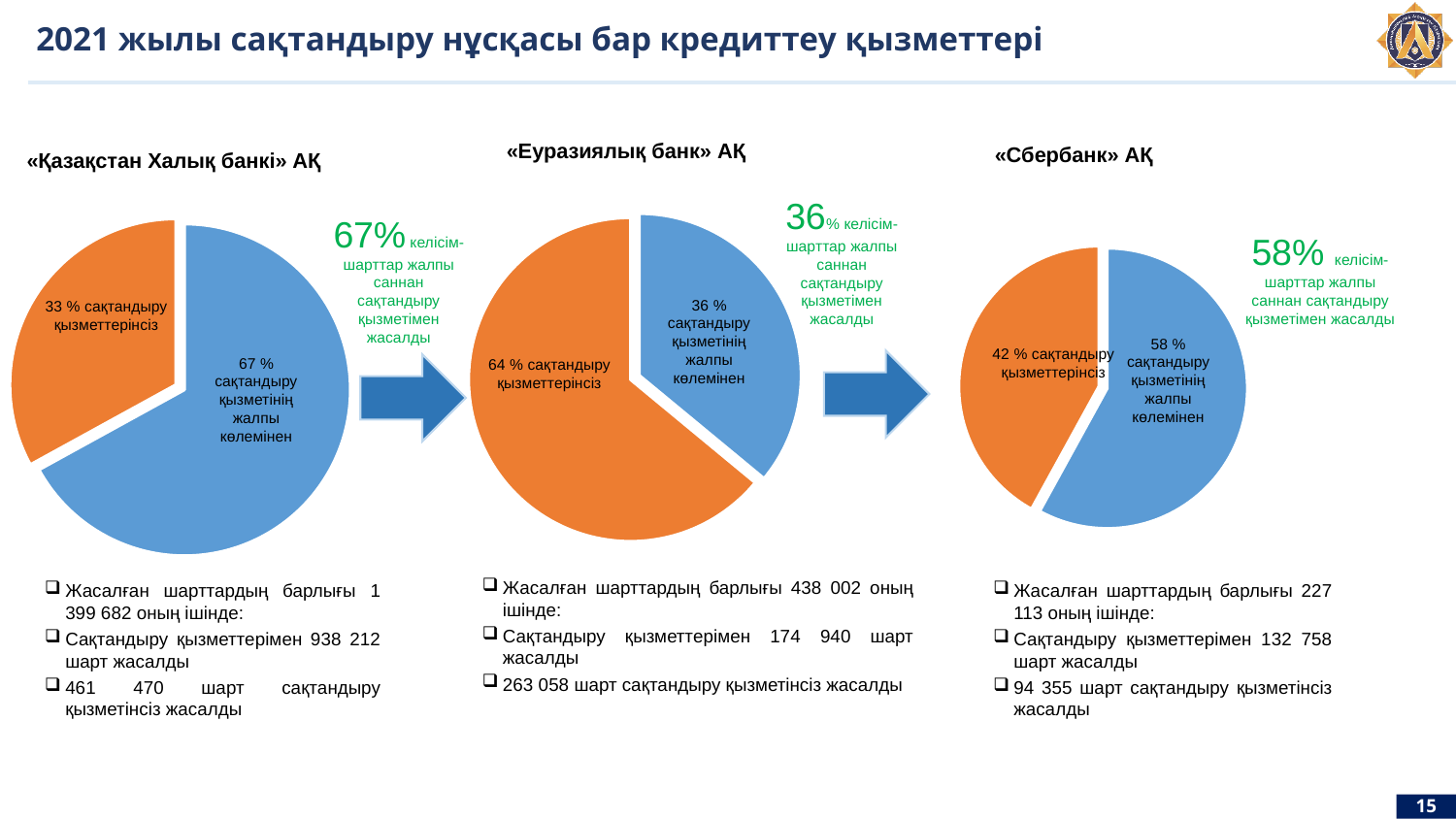
In the «Қазақстан Халық банкі» АҚ pie chart, what is the difference in percentage points between the slice with insurance services and the slice without? 34 In the «Сбербанк» АҚ pie chart, what share of contracts was made with insurance services? 58 % How many pie charts are shown on the slide? 3 How many slices does the «Сбербанк» АҚ pie chart have? 2 In the «Еуразиялық банк» АҚ pie chart, what share of contracts was made without insurance services? 64 % In the «Қазақстан Халық банкі» АҚ pie chart, what share of contracts was made with insurance services? 67 % In the «Сбербанк» АҚ pie chart, what is the difference in percentage points between the slice with insurance services and the slice without? 16 What type of chart is used for «Қазақстан Халық банкі» АҚ? Pie chart In the «Еуразиялық банк» АҚ pie chart, which slice is larger: with insurance services or without insurance services? Without insurance services In the «Сбербанк» АҚ pie chart, what share of contracts was made without insurance services? 42 % In the «Қазақстан Халық банкі» АҚ pie chart, what share of contracts was made without insurance services? 33 % In the «Еуразиялық банк» АҚ pie chart, what share of contracts was made with insurance services? 36 %